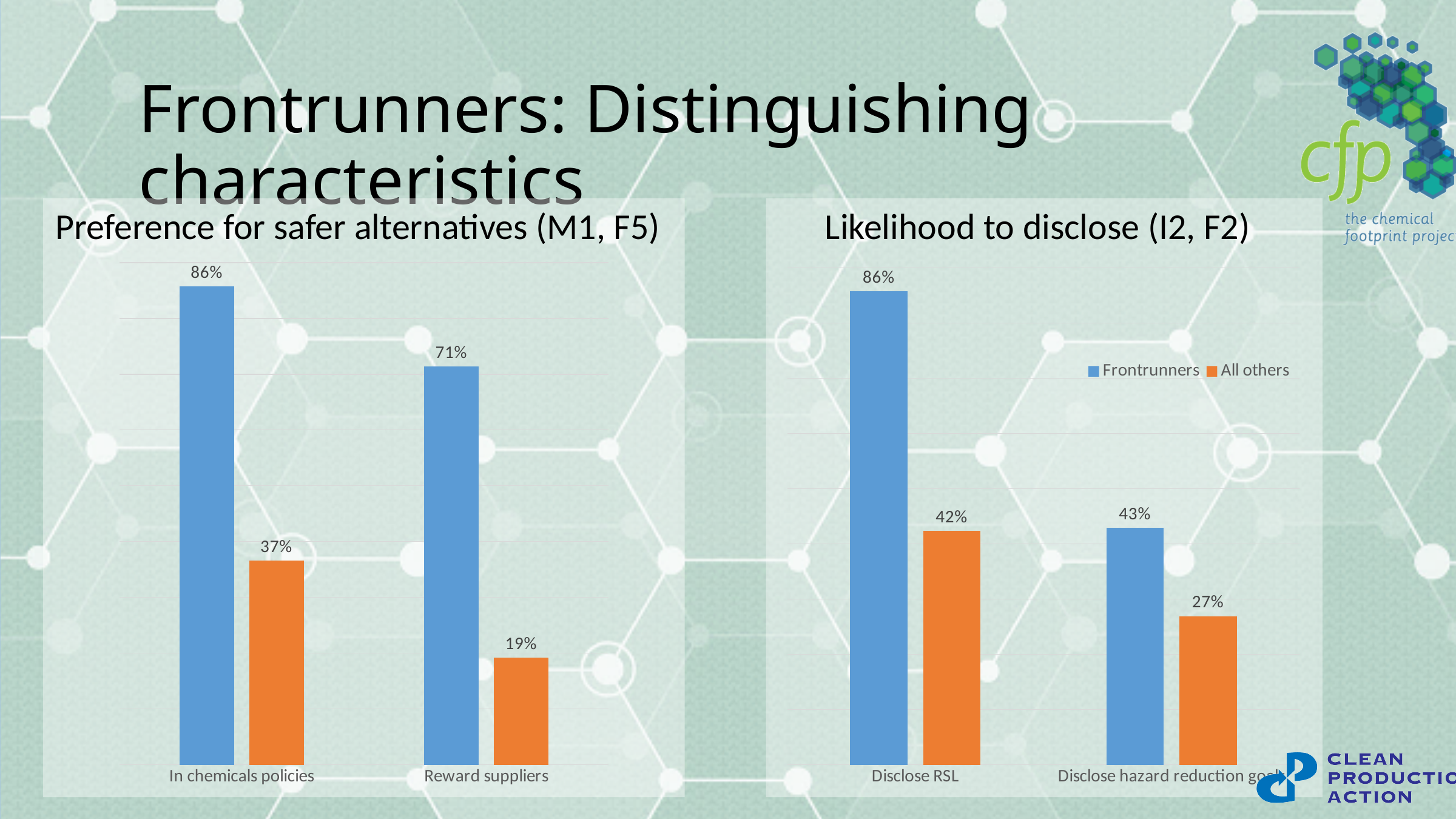
In the 'Likelihood to disclose (I2, F2)' chart, which bar is the highest? Frontrunners for 'Disclose RSL' (86%) In the 'Preference for safer alternatives (M1, F5)' chart, what is the value of the orange bar for 'Reward suppliers'? 19% In the 'Likelihood to disclose (I2, F2)' chart, what is the All others value for 'Disclose hazard reduction goals'? 27% In the 'Likelihood to disclose (I2, F2)' chart, which colour represents 'All others'? Orange In the 'Preference for safer alternatives (M1, F5)' chart, what is the difference between the blue and orange bars for 'In chemicals policies'? 49% In the 'Likelihood to disclose (I2, F2)' chart, which is larger: the Frontrunners value for 'Disclose hazard reduction goals' or the All others value for 'Disclose RSL'? Frontrunners value for 'Disclose hazard reduction goals' In the 'Likelihood to disclose (I2, F2)' chart, what is the difference between the Frontrunners and All others values for 'Disclose RSL'? 44% In the 'Likelihood to disclose (I2, F2)' chart, what is the Frontrunners value for 'Disclose RSL'? 86% In the 'Preference for safer alternatives (M1, F5)' chart, what is the value of the blue bar for 'In chemicals policies'? 86% What type of chart is the 'Preference for safer alternatives (M1, F5)' chart? Bar chart In the 'Preference for safer alternatives (M1, F5)' chart, which bar is the lowest? Orange bar for 'Reward suppliers' (19%) How many series does the legend in the 'Likelihood to disclose (I2, F2)' chart list? 2